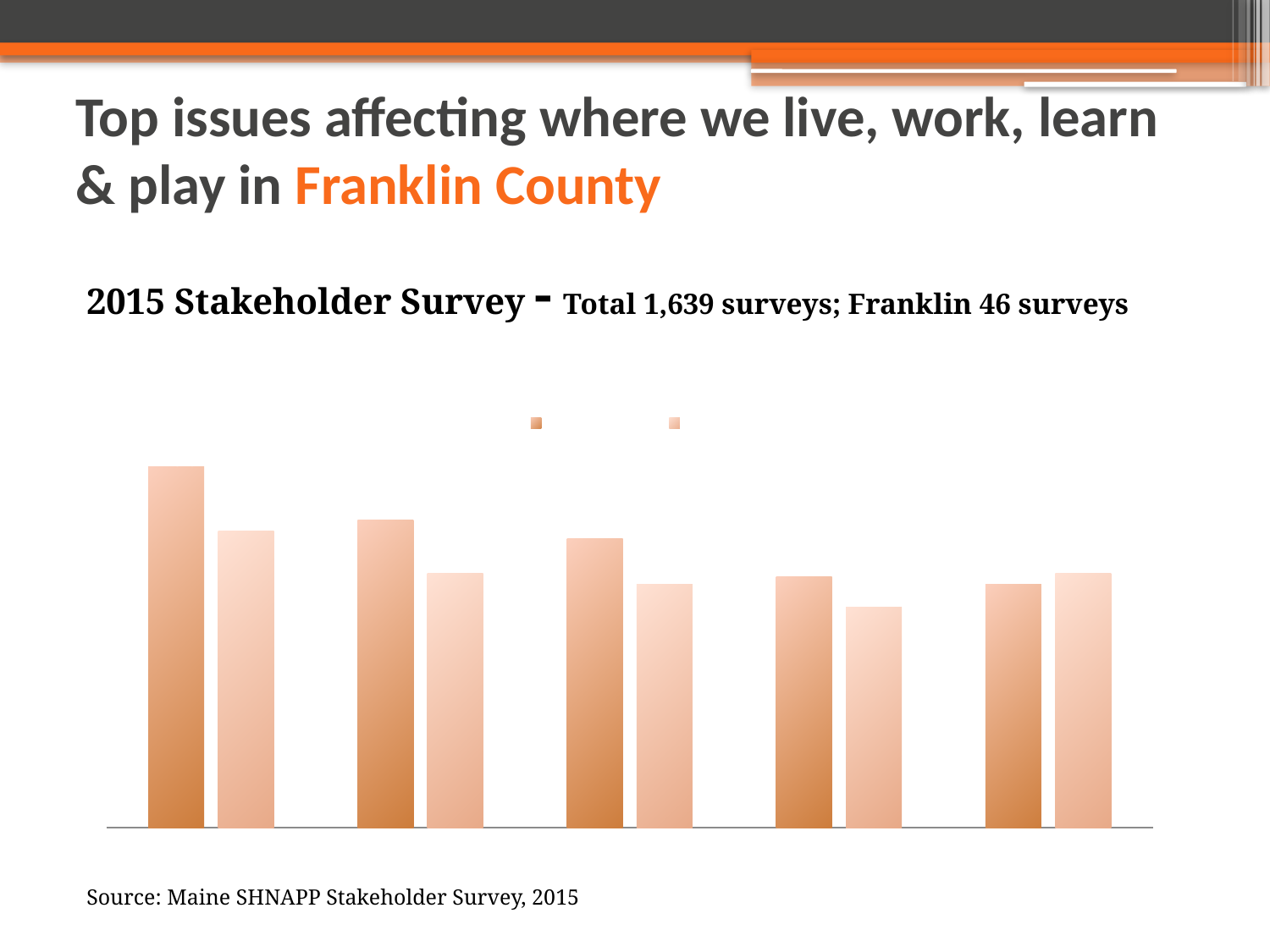
How many series does the chart's legend show? 2 In the rightmost group of bars, is the darker orange bar or the lighter orange bar taller? the lighter orange bar Do the darker orange bars generally rise or fall from left to right across the chart? fall How many groups of bars are plotted in the chart? 5 Which group of bars, counting from the left, contains the tallest bar in the chart? the first (leftmost) group What kind of chart is shown on the slide? bar chart Which group of bars, counting from the left, contains the shortest lighter orange bar? the fourth group What two colours are used for the bars in the chart? darker orange and lighter orange How many bars in total are plotted in the chart? 10 In the leftmost group of bars, is the darker orange bar or the lighter orange bar taller? the darker orange bar